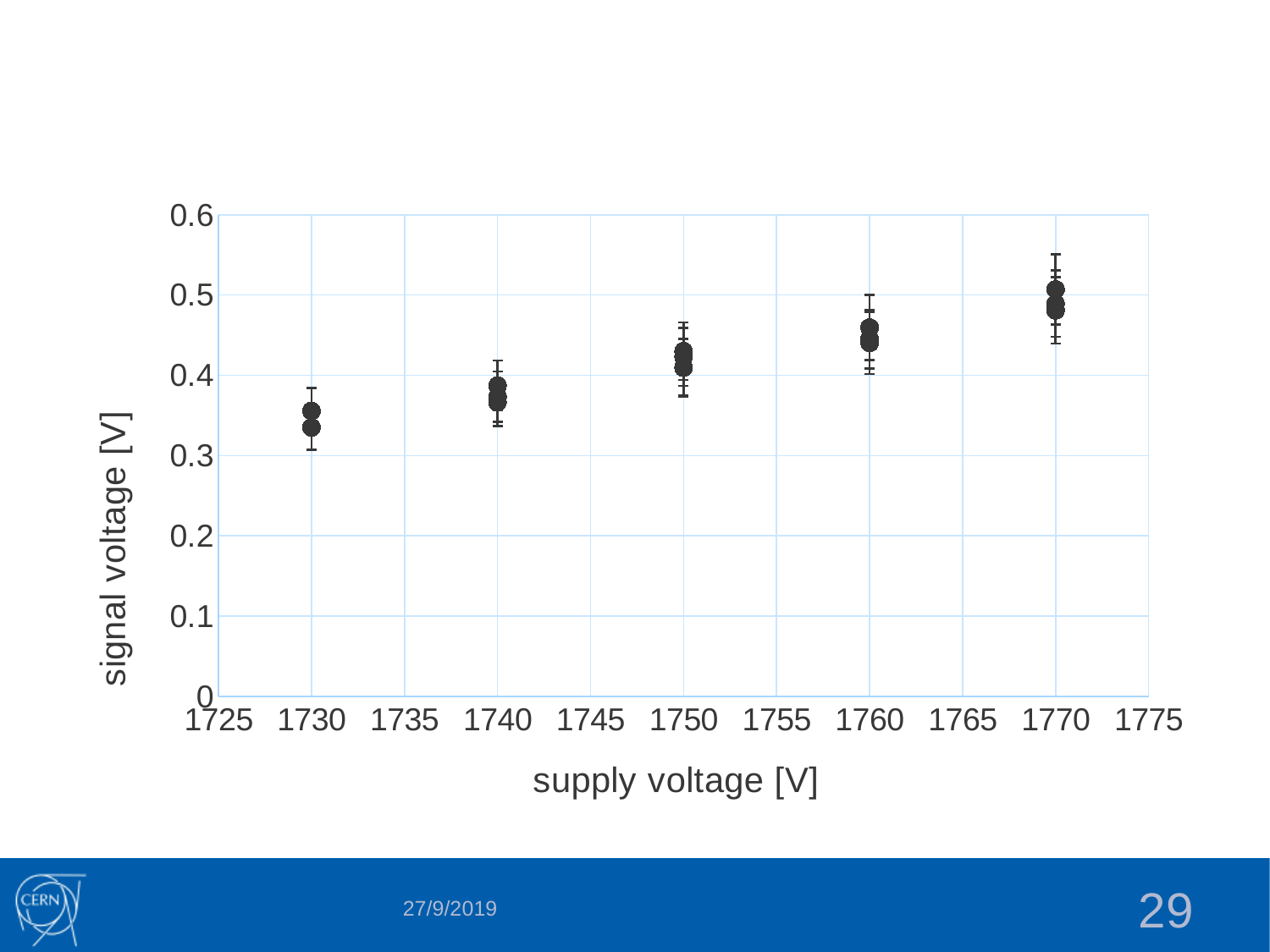
Are the signal voltage values at a supply voltage of 1770 V greater or less than 0.4? greater Which supply voltage has the highest signal voltage values, 1730 V or 1770 V? 1770 V What is the label of the x axis? supply voltage [V] At how many distinct supply voltage values are data points plotted? 5 What kind of chart is shown on the slide? scatter plot What is the label of the y axis? signal voltage [V] Are the signal voltage values at a supply voltage of 1730 V greater or less than 0.4? less Are the signal voltage values at a supply voltage of 1760 V greater or less than 0.4? greater At which supply voltage are the signal voltage values lowest? 1730 V Does the signal voltage rise or fall as the supply voltage increases from 1730 V to 1770 V? rise